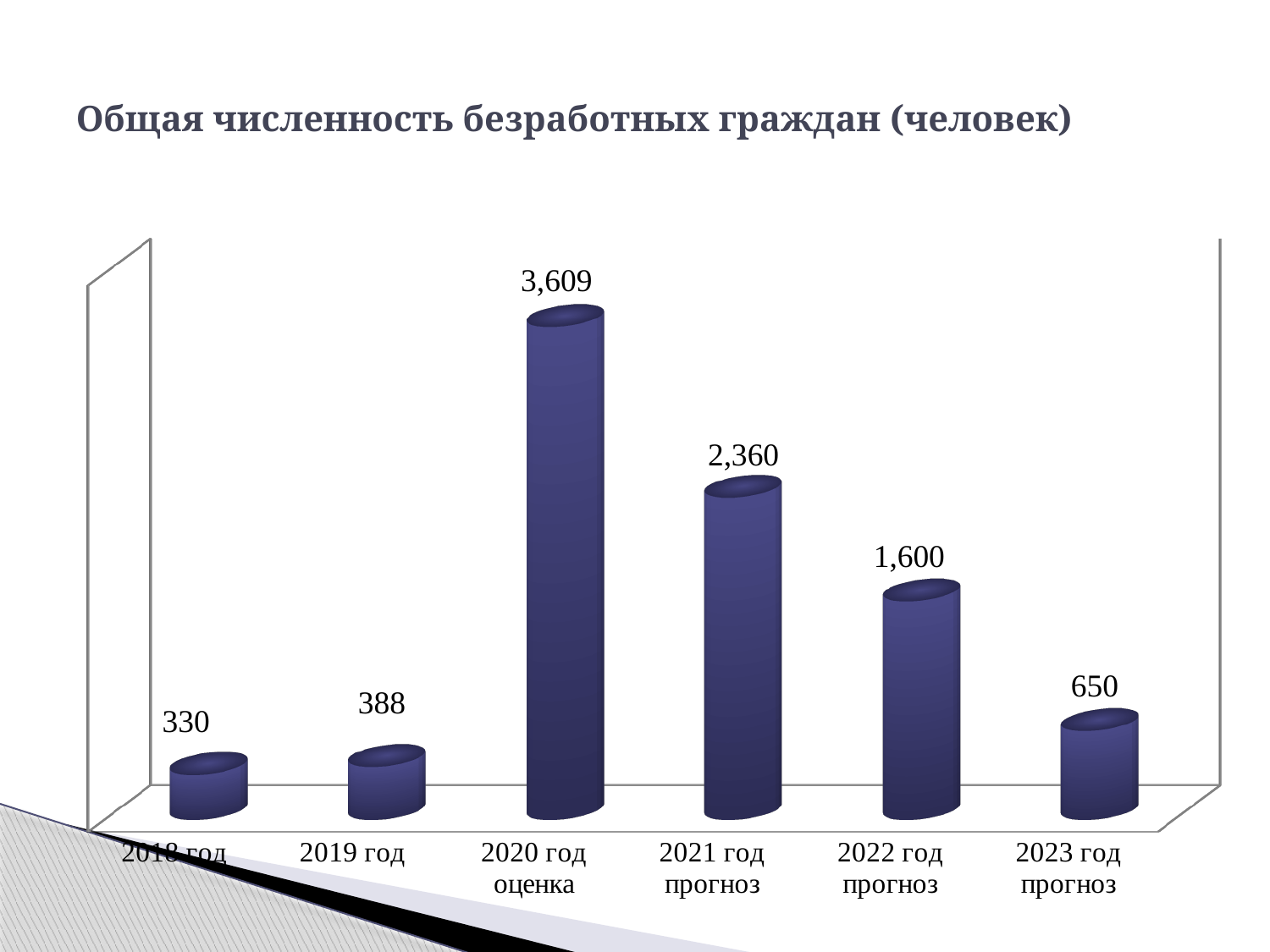
What is the value for 2023 год прогноз? 650 Which category has the lowest value? 2018 год Which category has the highest value? 2020 год оценка What kind of chart is shown on the slide? bar chart How many categories are shown on the chart? 6 What is the value for 2022 год прогноз? 1,600 What is the value for 2018 год? 330 What is the difference between the values for 2019 год and 2018 год? 58 What is the title of the chart? Общая численность безработных граждан (человек) What is the difference between the values for 2020 год оценка and 2021 год прогноз? 1,249 Which is larger, the value for 2021 год прогноз or the value for 2022 год прогноз? 2021 год прогноз What is the value for 2020 год оценка? 3,609